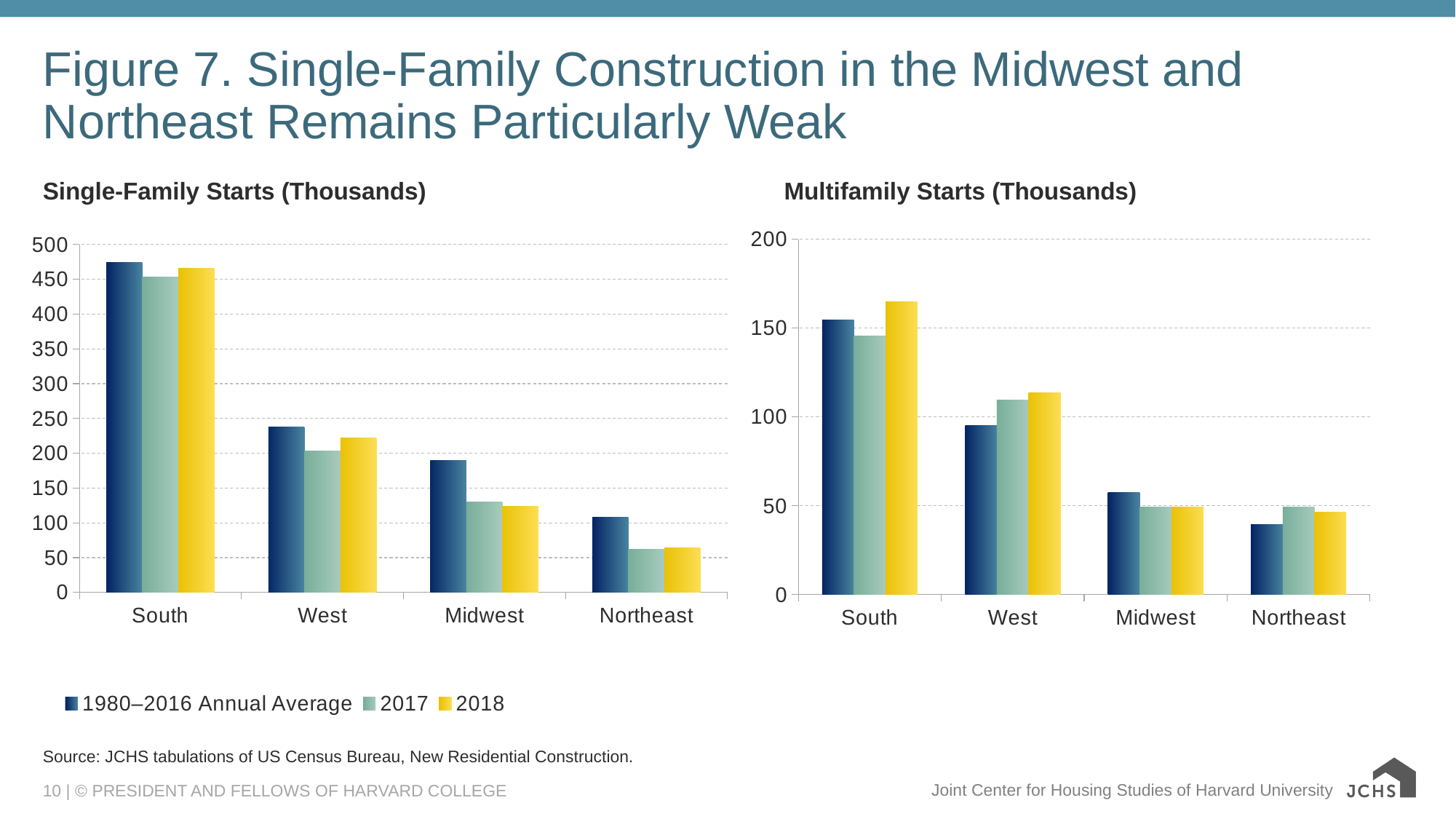
In the Multifamily Starts (Thousands) chart, which region has the highest 2018 value? South In the Single-Family Starts (Thousands) chart, which region has the lowest 2017 value? Northeast In the Single-Family Starts (Thousands) chart, is the 2018 value for South greater or less than 400? greater How many series does the legend list for the charts? 3 In the Single-Family Starts (Thousands) chart, for West, which is larger: the 1980–2016 Annual Average or the 2018 value? 1980–2016 Annual Average What kind of chart is the Single-Family Starts (Thousands) chart? bar chart In the Multifamily Starts (Thousands) chart, for West, which is larger: the 1980–2016 Annual Average or the 2018 value? 2018 How many regions are shown on the x axis of the Multifamily Starts (Thousands) chart? 4 In the Single-Family Starts (Thousands) chart, is the 2017 value for Midwest greater or less than 150? less In the Single-Family Starts (Thousands) chart, which region has the highest 2018 value? South In the Multifamily Starts (Thousands) chart, is the 2018 value for South greater or less than 150? greater What is the title of the chart on the right side of the slide? Multifamily Starts (Thousands)